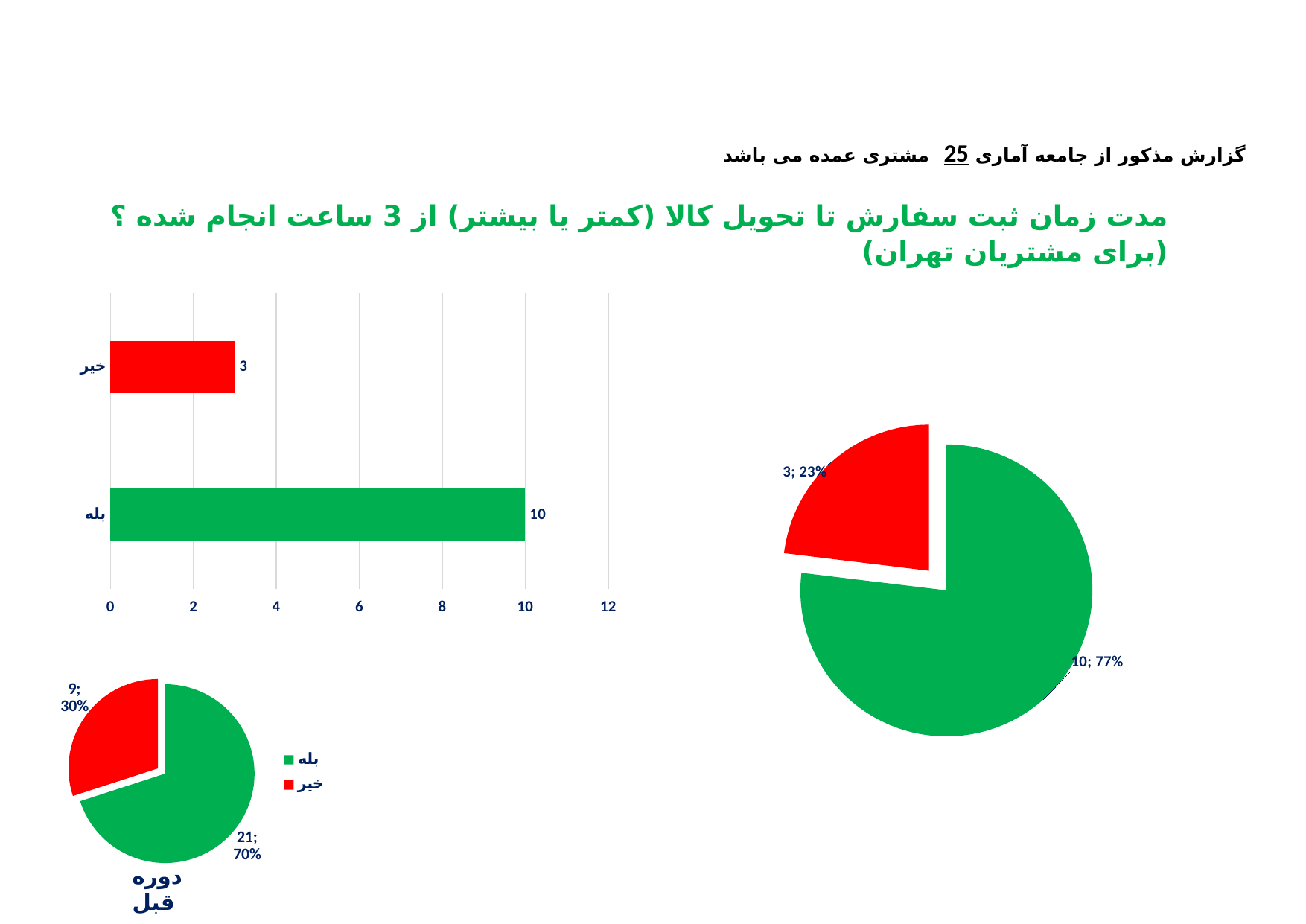
In the bar chart at the top left, what is the difference between the values for بله and خیر? 7 In the large pie chart on the right, what share does the red slice (خیر) represent? 23% In the bar chart at the top left, which category has the highest value? بله How many entries does the legend next to the small pie chart at the bottom left list? 2 In the large pie chart on the right, what is the value of the green slice (بله)? 10 In the bar chart at the top left, what is the value for بله? 10 In the small pie chart labelled دوره قبل at the bottom left, what share does the green slice (بله) represent? 70% In the small pie chart labelled دوره قبل at the bottom left, which slice is larger, بله or خیر? بله How many categories does the bar chart at the top left show? 2 What kind of chart is the chart at the top left of the slide? bar chart In the bar chart at the top left, what is the value for خیر? 3 In the small pie chart labelled دوره قبل at the bottom left, what is the value of the red slice (خیر)? 9